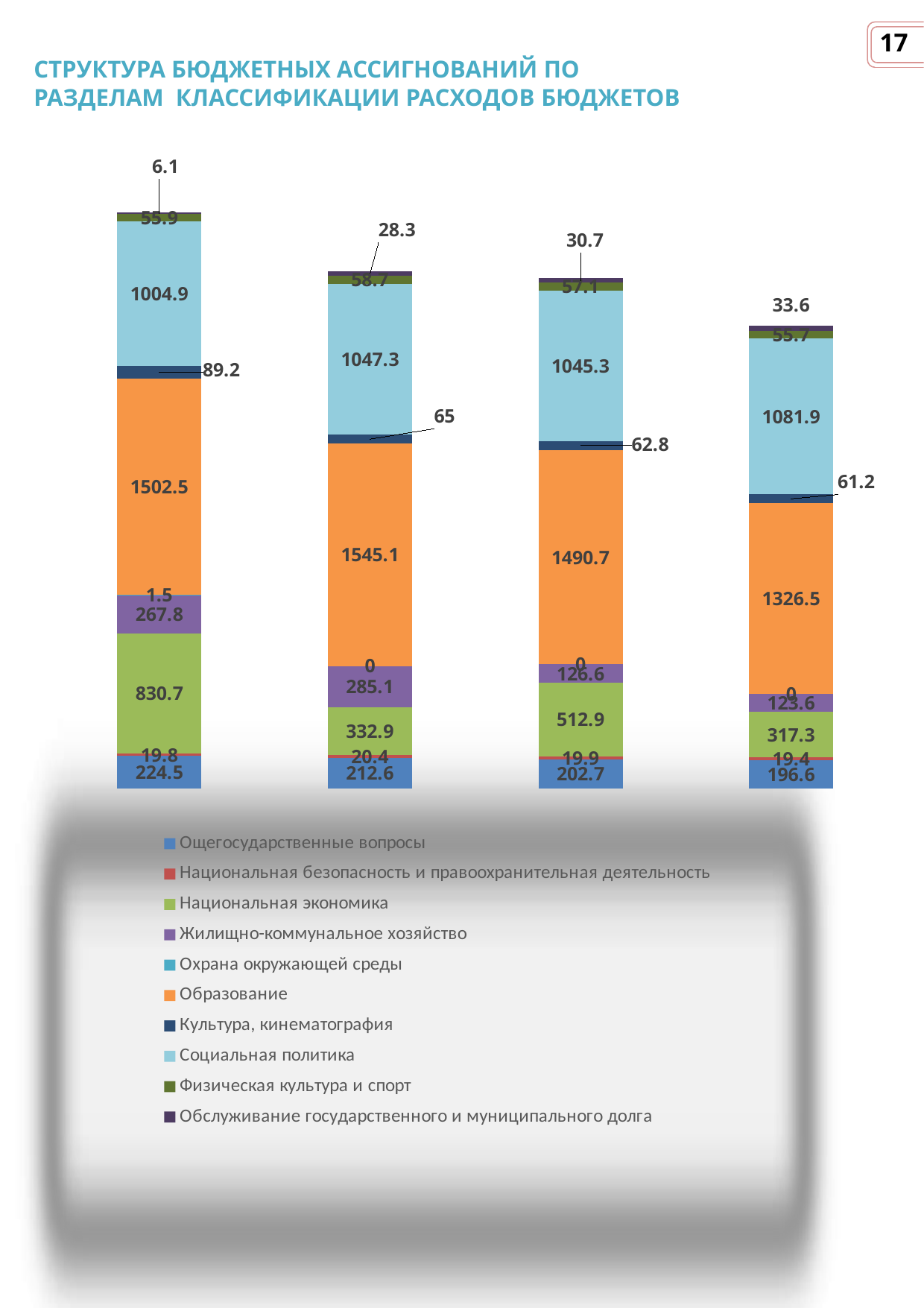
What is the value of the Национальная экономика segment in the third bar from the left? 512.9 Which is larger: the Жилищно-коммунальное хозяйство segment in the second bar or in the third bar from the left? the second bar What is the value of the Социальная политика segment in the fourth bar from the left? 1081.9 How many series does the legend list? 10 How many bars are plotted in the chart? 4 In which bar is the Национальная экономика segment the largest? the first bar from the left What kind of chart is shown on the slide? stacked bar chart In which bar is the Образование segment the smallest? the fourth bar from the left What is the value of the Обслуживание государственного и муниципального долга segment in the second bar from the left? 28.3 Do the Ощегосударственные вопросы values rise or fall from the first bar to the fourth bar? fall What is the value of the Образование segment in the first bar from the left? 1502.5 What is the difference between the Образование values in the second and fourth bars from the left? 218.6